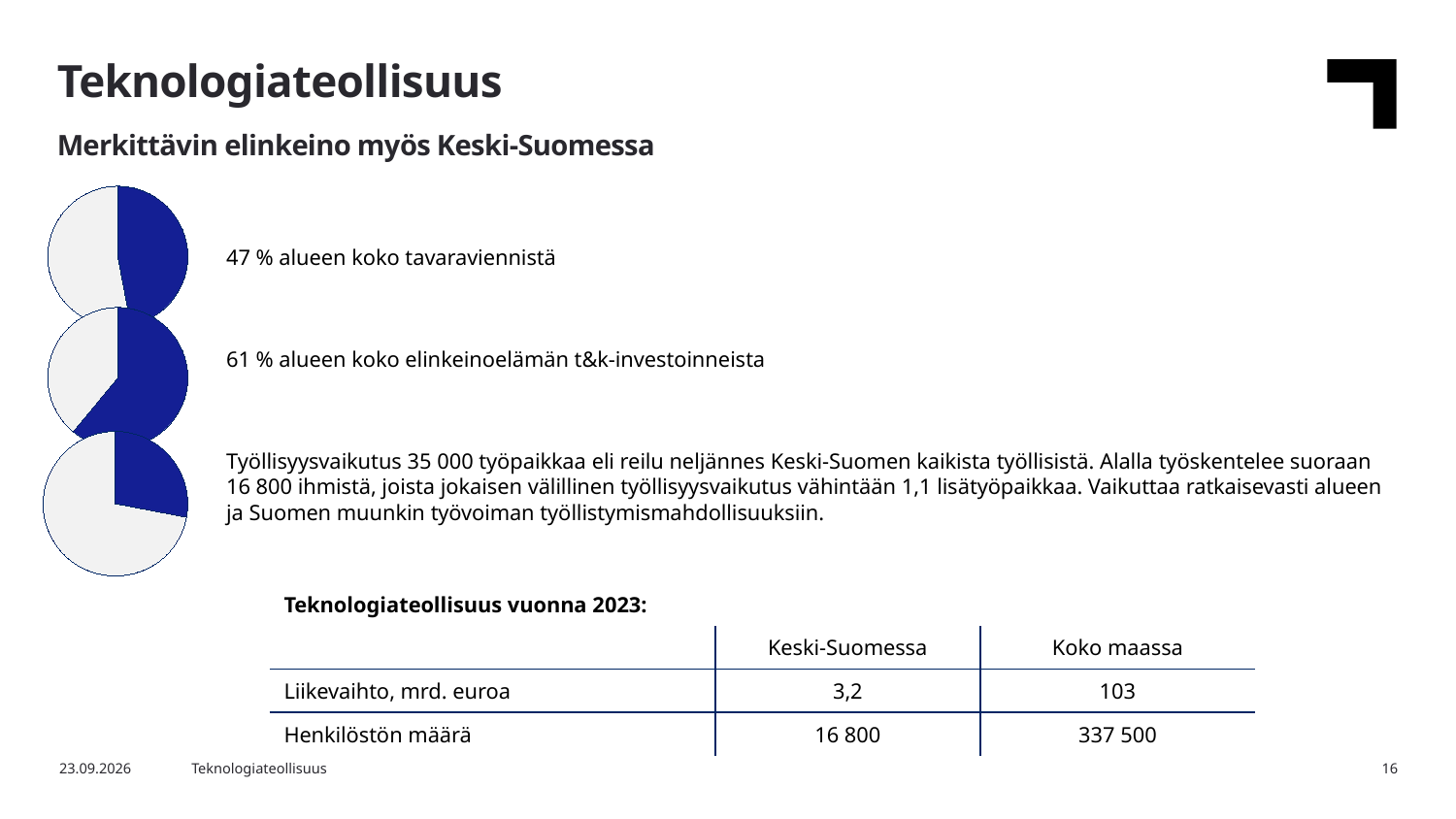
Of the three pie charts, which one has the largest blue slice? the middle one What colour is the highlighted slice in the pie charts? blue Of the three pie charts, which one has the smallest blue slice? the bottom one How many pie charts are on the slide? 3 In the top pie chart, what share does the blue slice represent according to the text beside it? 47 % In the middle pie chart, what share does the blue slice represent according to the text beside it? 61 % What does the top pie chart represent, according to the text next to it? 47 % alueen koko tavaraviennistä What kind of chart is shown at the top left of the slide? pie chart In the middle pie chart, is the blue slice larger or smaller than the grey slice? larger How many slices does each pie chart have? 2 Which pie chart has the larger blue slice, the top one or the middle one? the middle one In the bottom pie chart, is the blue slice larger or smaller than the grey slice? smaller